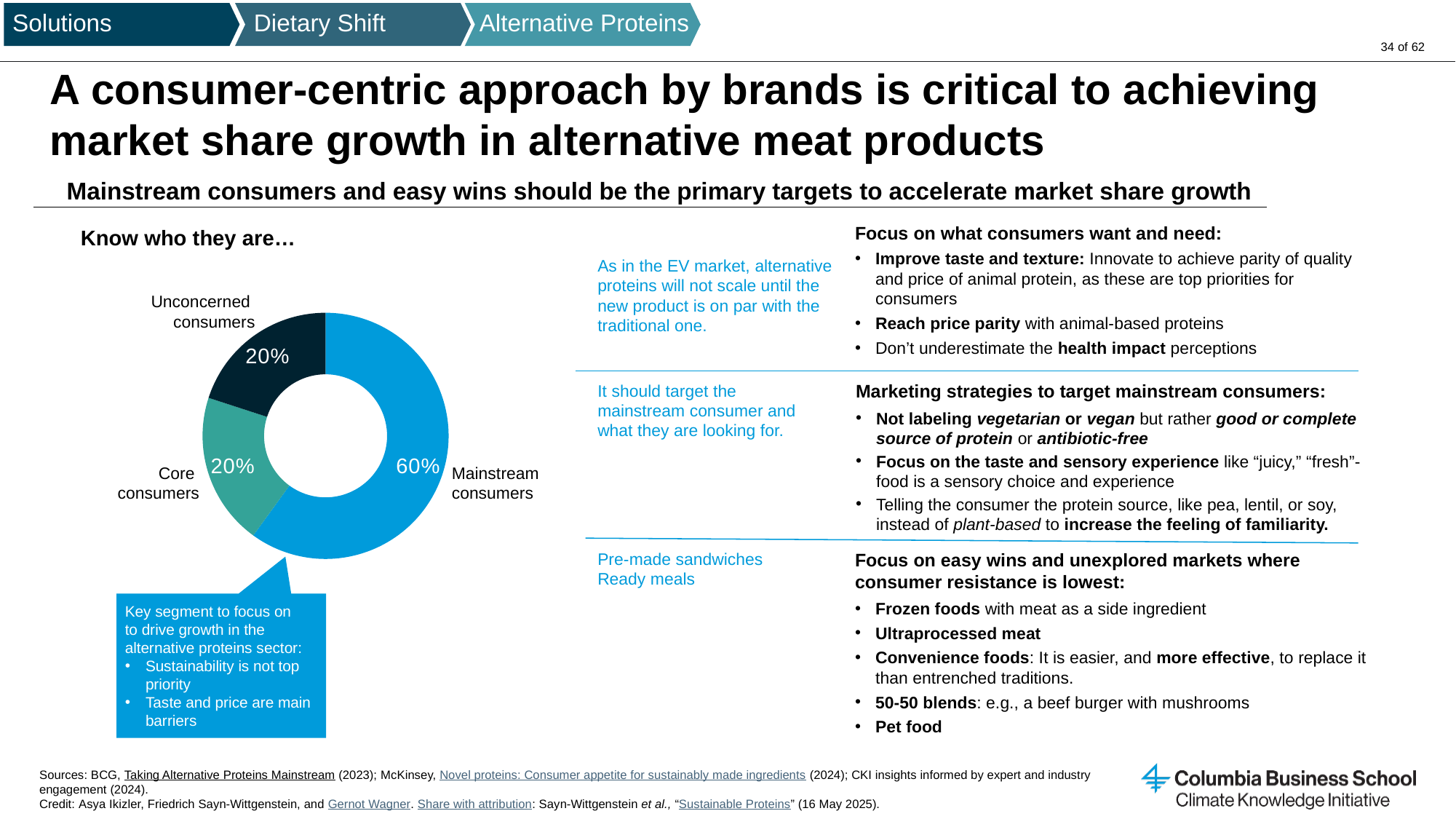
What is the combined share of Core consumers and Unconcerned consumers in the donut chart? 40% Which consumer segment has the largest share in the donut chart? Mainstream consumers Which is larger in the donut chart: the Mainstream consumers share or the Unconcerned consumers share? Mainstream consumers What share of the donut chart is labelled Unconcerned consumers? 20% What kind of chart is used to show the consumer segments? Donut (pie) chart What is the difference in percentage points between the Mainstream consumers share and the Core consumers share? 40 percentage points What is the heading above the donut chart? Know who they are… What share of the donut chart is labelled Mainstream consumers? 60% How many consumer segments are shown in the donut chart? 3 Which segment of the donut chart is shown in the darkest colour? Unconcerned consumers What share of the donut chart is labelled Core consumers? 20%